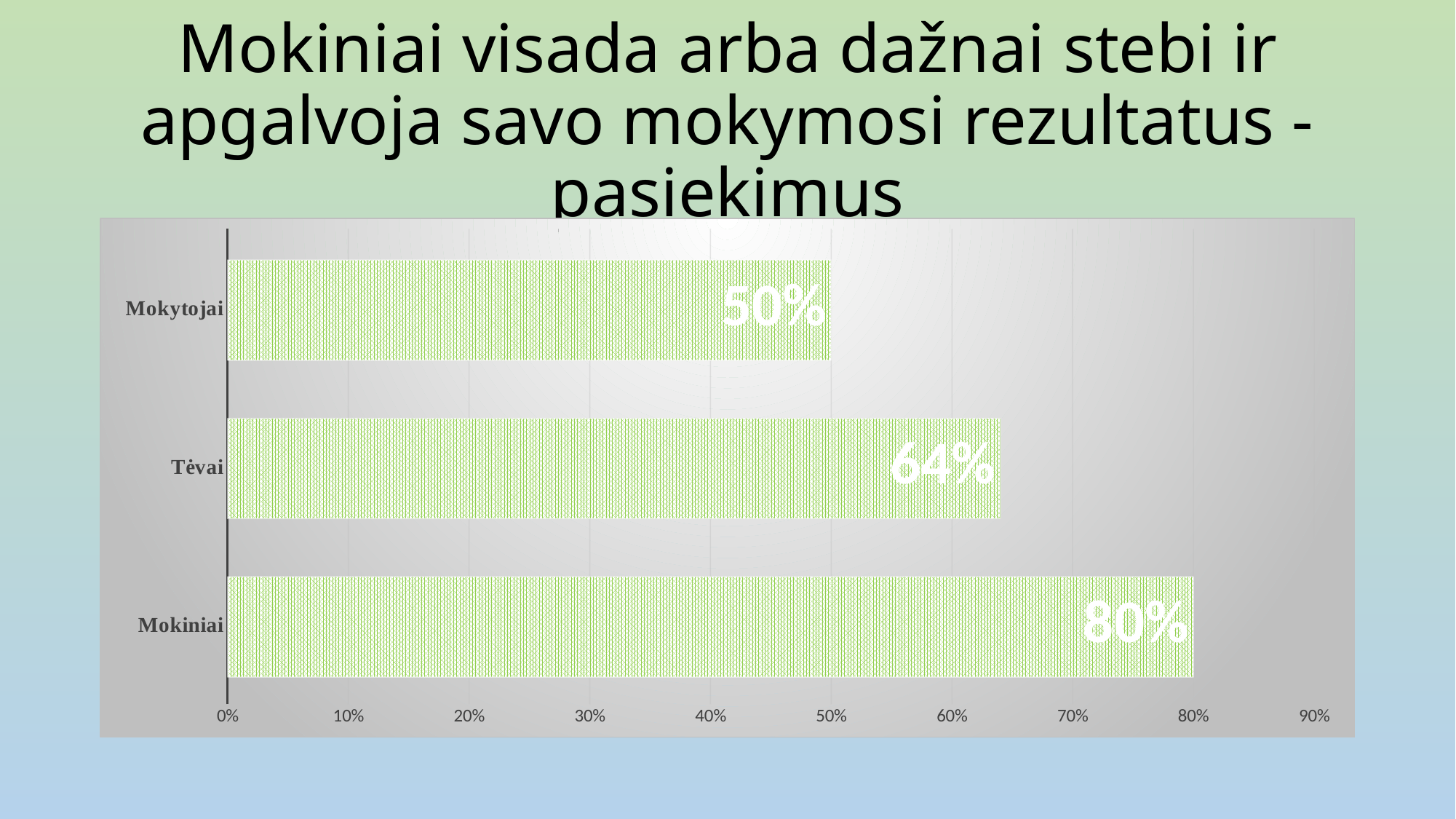
What is the difference between the values for Tėvai and Mokytojai? 14% What is the value for Tėvai? 64% What is the highest value shown on the horizontal axis? 90% Which is larger, the value for Tėvai or the value for Mokytojai? Tėvai How many categories are shown in the chart? 3 What is the value for Mokytojai? 50% Is the value for Tėvai greater or less than 70%? less Which category has the lowest value? Mokytojai Which category has the highest value? Mokiniai What is the difference between the values for Mokiniai and Mokytojai? 30% What kind of chart is shown on the slide? bar chart What is the value for Mokiniai? 80%